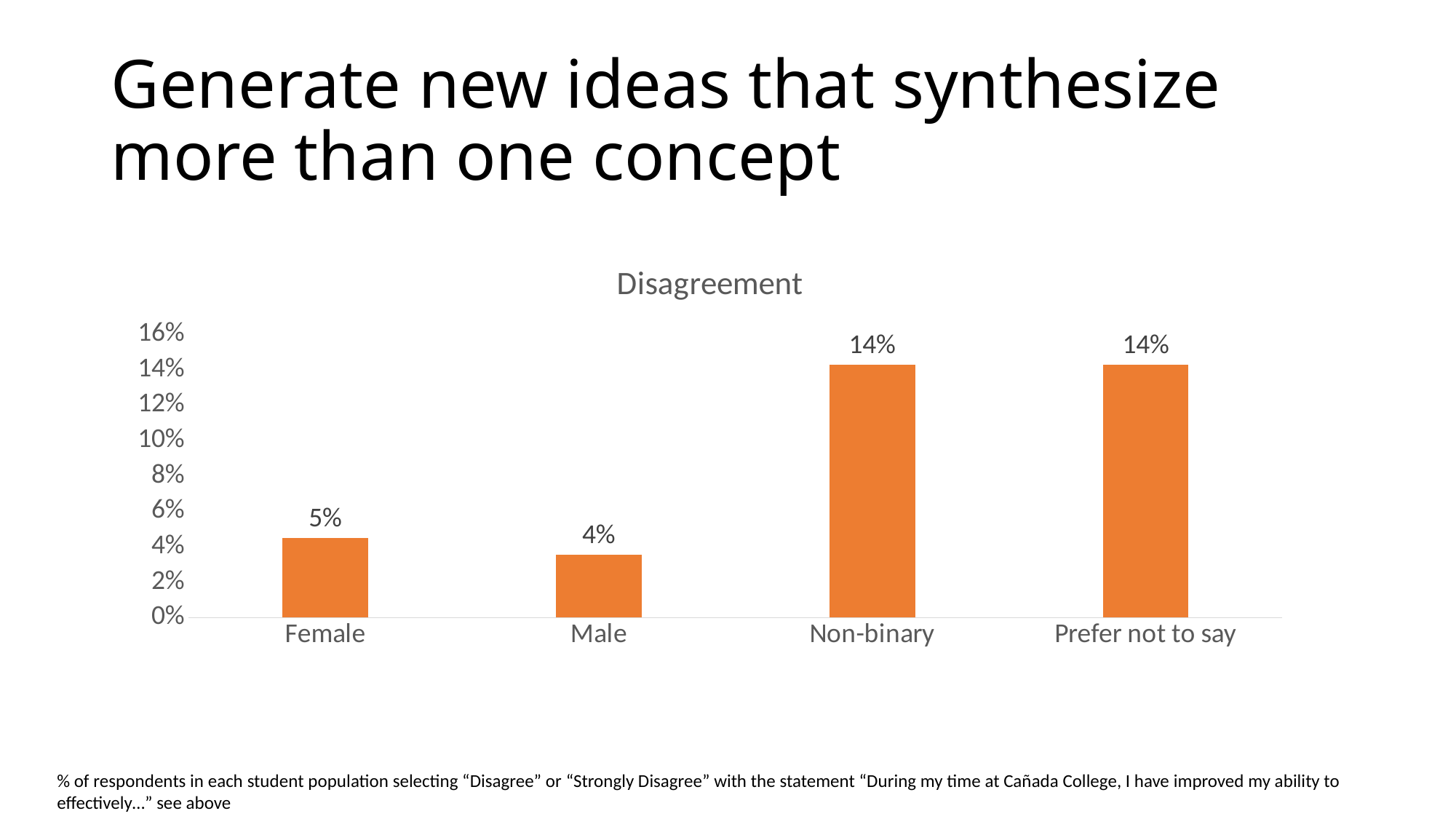
What is the difference between the value for Non-binary and the value for Female? 9% What is the value for Prefer not to say? 14% What kind of chart is shown on the slide? bar chart What is the value for Non-binary? 14% Which is larger, the value for Female or the value for Male? Female Which category has the lowest value? Male What is the difference between the value for Female and the value for Male? 1% What is the value for Male? 4% How many categories are shown on the x axis? 4 What is the value for Female? 5% Is the value for Non-binary greater or less than 10%? greater What is the title of the chart? Disagreement